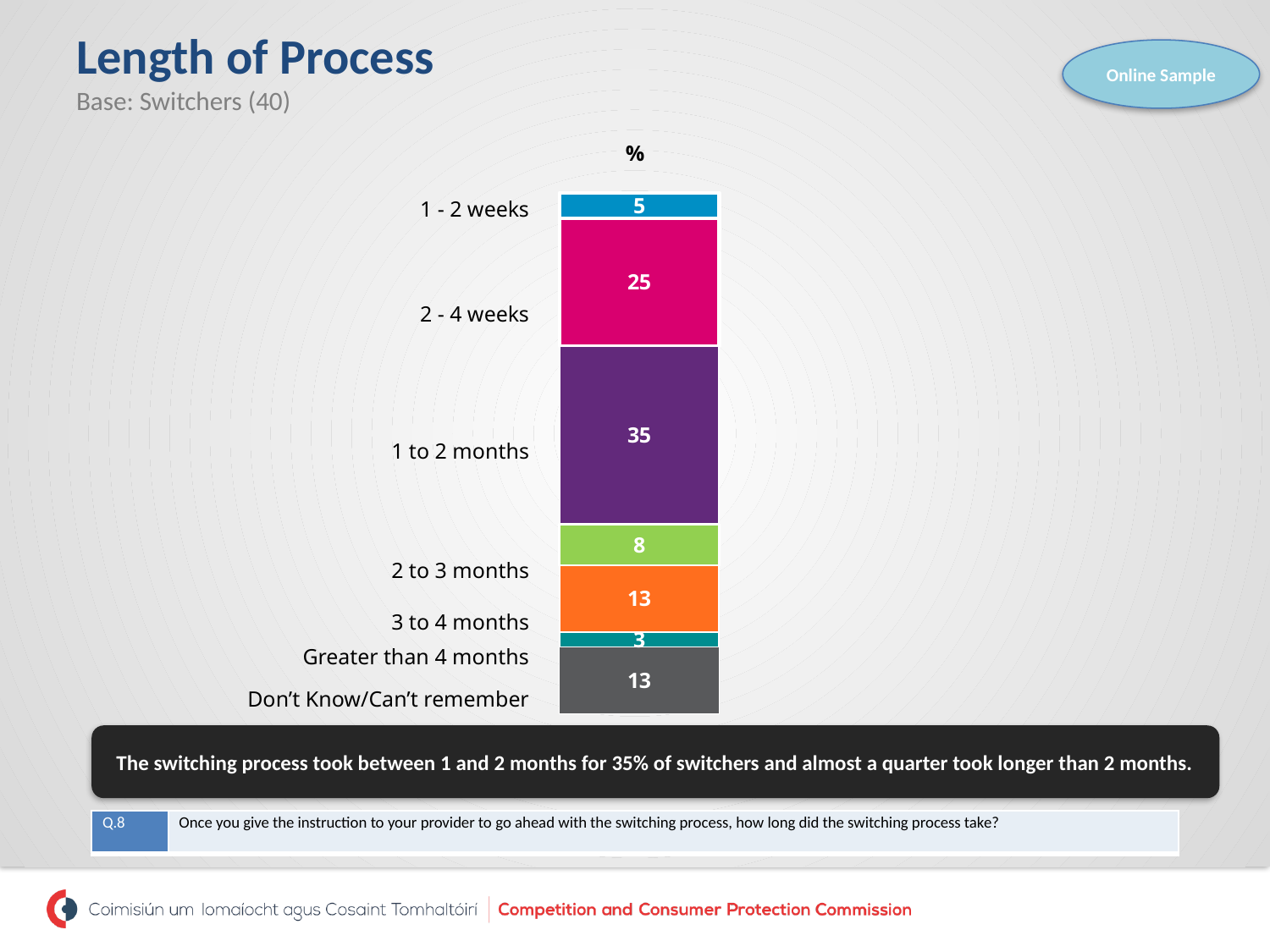
What kind of chart is shown on the slide? Stacked bar chart Which category has the highest value? 1 to 2 months Which is larger, the value for 3 to 4 months or the value for 2 to 3 months? 3 to 4 months What is the difference between the values for 1 to 2 months and 2 - 4 weeks? 10 What is the title of the slide containing the chart? Length of Process What is the value for 1 - 2 weeks? 5 What is the value for Don't Know/Can't remember? 13 What is the value for Greater than 4 months? 3 What is the value for 2 - 4 weeks? 25 How many categories are shown in the chart? 7 Which category has the lowest value? Greater than 4 months What is the value for 1 to 2 months? 35